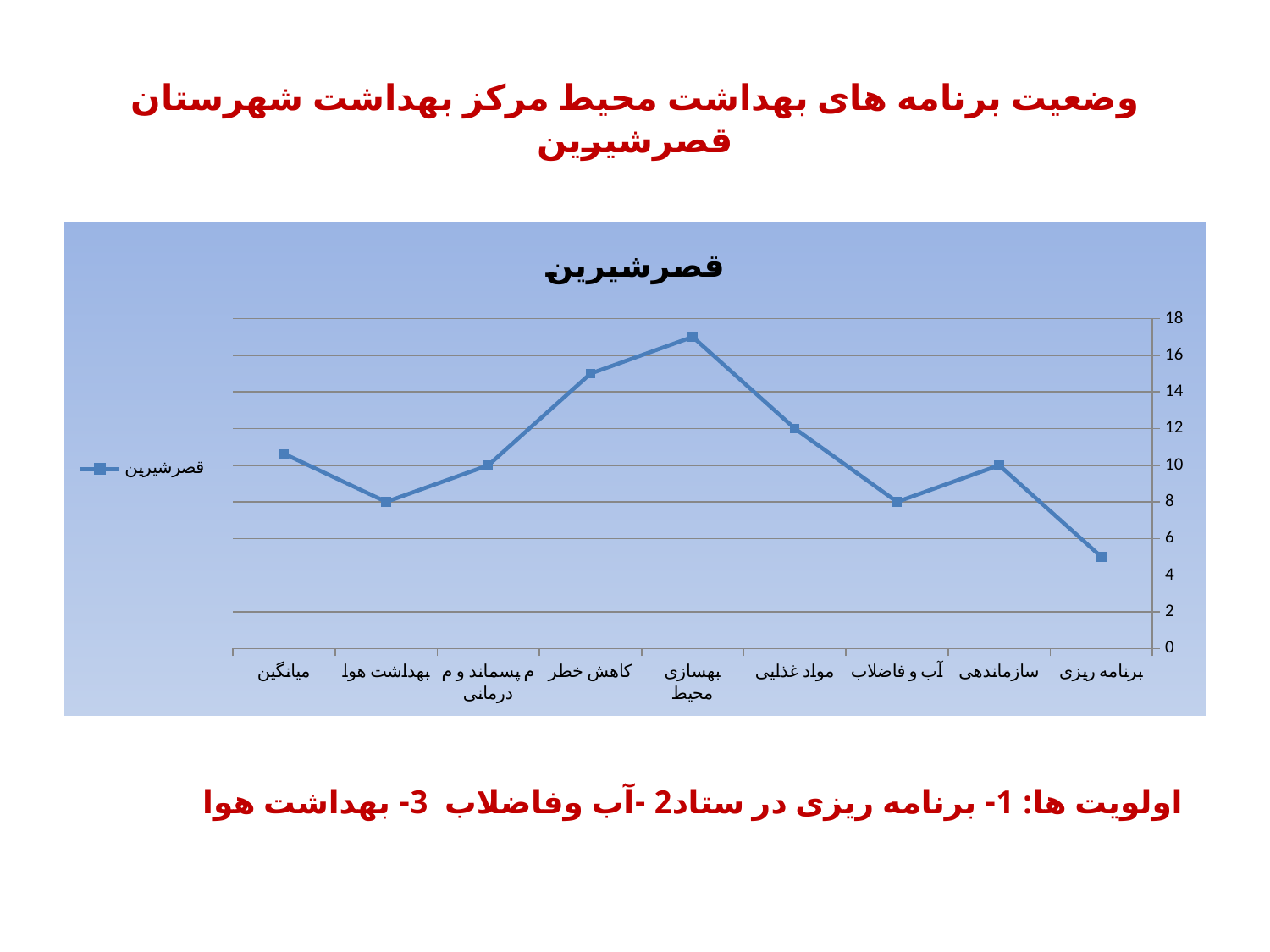
What is the title of the chart? قصرشیرین What type of chart is shown on the slide? line chart What is the value for بهداشت هوا? 8 What is the difference between the values for مواد غذایی and آب و فاضلاب? 4 How many categories are plotted along the x axis? 9 Is the value for بهسازی محیط greater or less than 16? greater Which category has the lowest value? برنامه ریزی How many series does the legend list? 1 Which is larger, the value for مواد غذایی or the value for سازماندهی? مواد غذایی What is the value for مواد غذایی? 12 What is the value for سازماندهی? 10 Which category has the highest value? بهسازی محیط